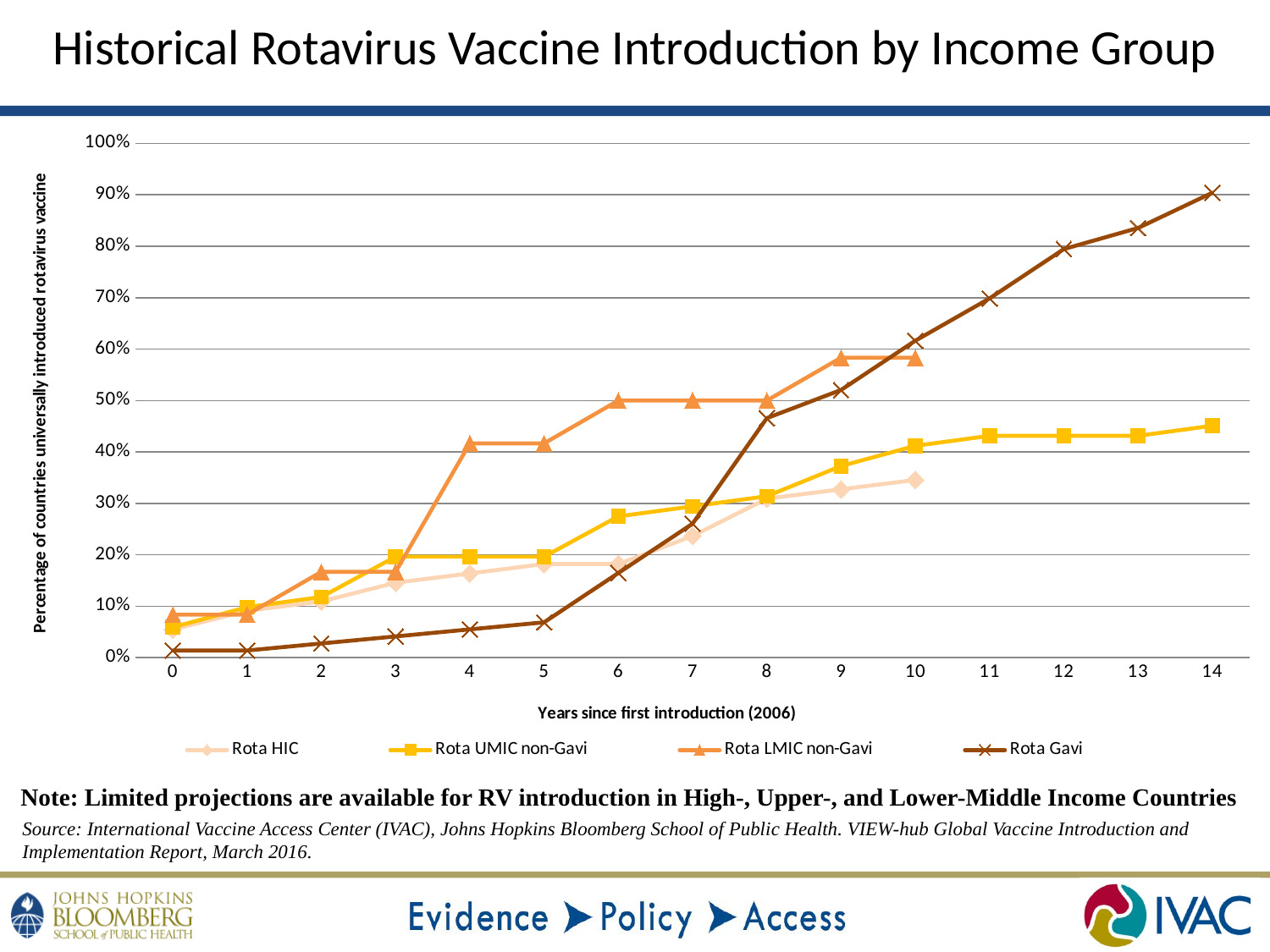
Is the value for Rota UMIC non-Gavi at year 14 greater or less than 50%? less How many series does the legend list? 4 Does the Rota Gavi series rise or fall as the years since first introduction increase? rise What is the title of the x axis? Years since first introduction (2006) Is the value for Rota HIC at year 10 greater or less than 30%? greater What kind of chart is shown on the slide? line chart Is the value for Rota Gavi at year 14 greater or less than 80%? greater Which series has the lowest value at year 0? Rota Gavi Which series has the highest value at year 14? Rota Gavi At year 5, which is larger: Rota LMIC non-Gavi or Rota Gavi? Rota LMIC non-Gavi How many year values are labelled along the x axis? 15